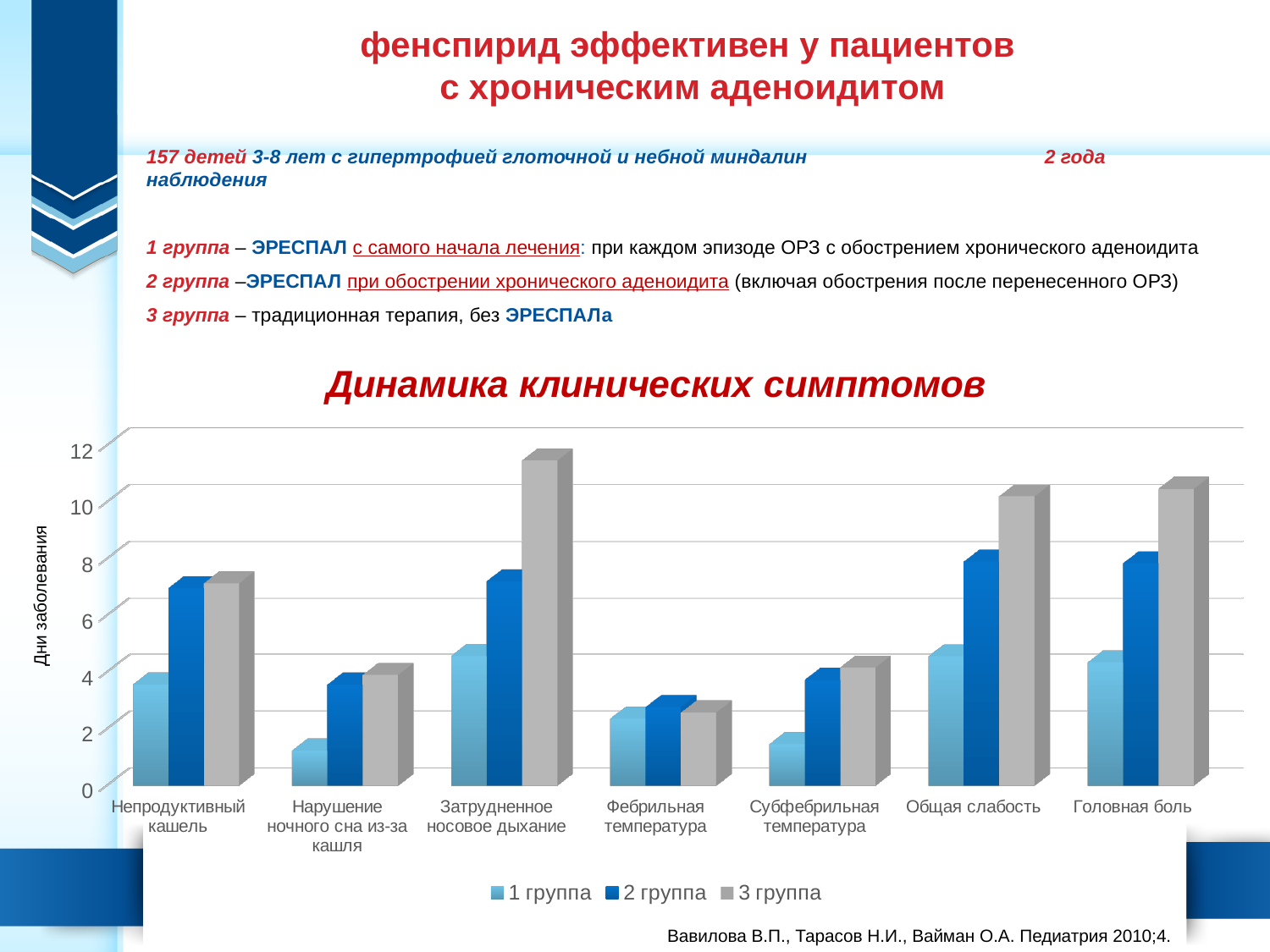
For which category is the 3 группа bar the highest? Затрудненное носовое дыхание What kind of chart is shown on the slide? bar chart Is the value for 3 группа in the category Затрудненное носовое дыхание greater or less than 10? greater How many symptom categories are shown on the x axis of the chart? 7 Is the value for 1 группа in the category Фебрильная температура greater or less than 4? less What is the title of the chart? Динамика клинических симптомов In the category Затрудненное носовое дыхание, which is larger: the value for 1 группа or for 3 группа? 3 группа Is the value for 2 группа in the category Головная боль greater or less than 6? greater How many series does the chart legend list? 3 What is the label of the vertical axis of the chart? Дни заболевания In the category Общая слабость, which is larger: the value for 1 группа or for 2 группа? 2 группа